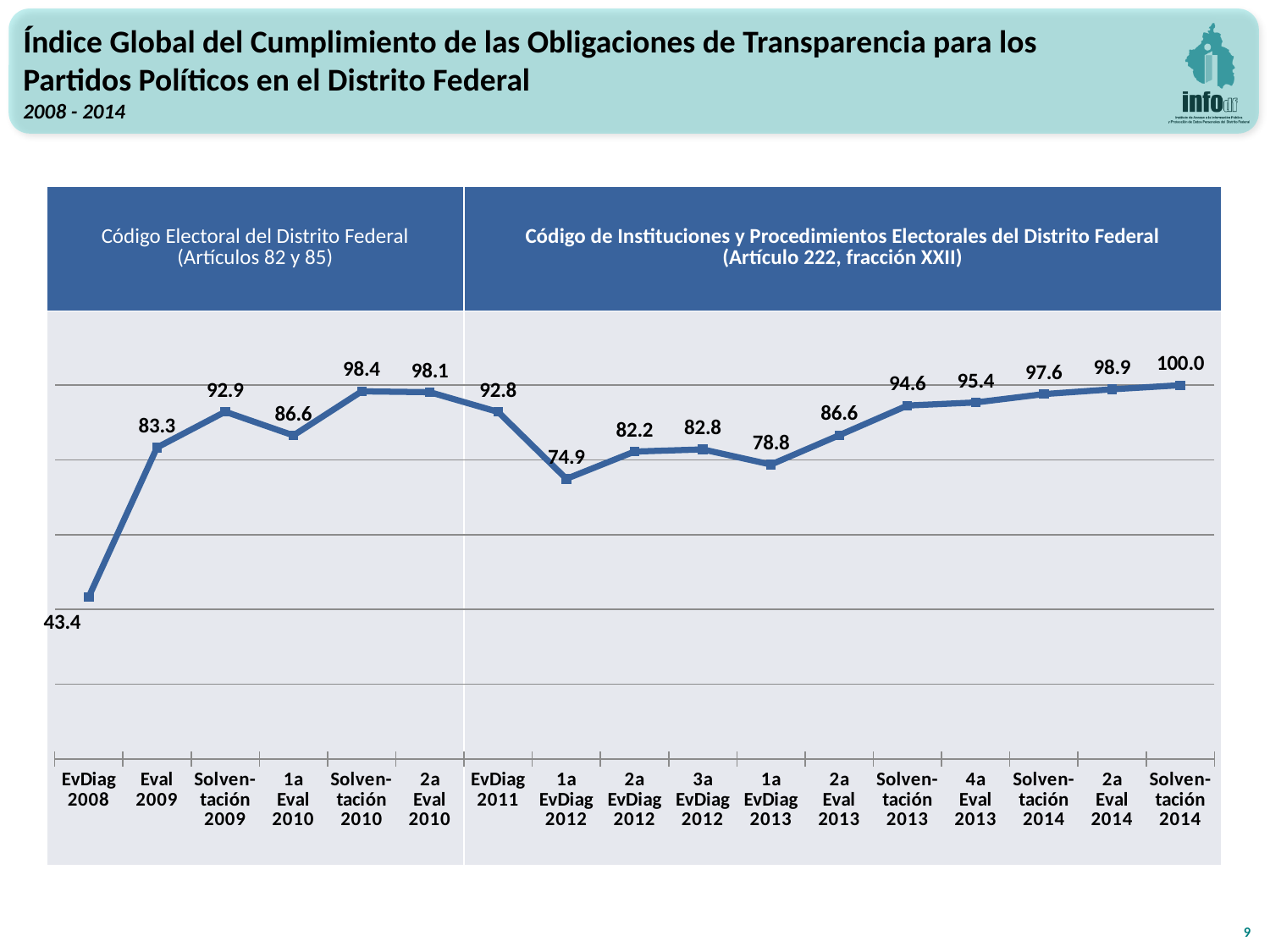
What is the value for Solventación 2010? 98.4 What is the value for EvDiag 2008? 43.4 What is the highest value shown on the chart? 100.0 Which legal code heading covers the first six data points of the chart? Código Electoral del Distrito Federal (Artículos 82 y 85) What is the difference between the values for Eval 2009 and EvDiag 2008? 39.9 Which is larger, the value for 3a EvDiag 2012 or the value for 1a EvDiag 2013? 3a EvDiag 2012 Which point has the lowest value on the chart? EvDiag 2008 Does the value rise or fall from EvDiag 2011 to 1a EvDiag 2012? Fall How many data points are plotted on the line chart? 17 What is the value for 2a Eval 2013? 86.6 What is the value for 1a EvDiag 2012? 74.9 What type of chart is shown on the slide? Line chart